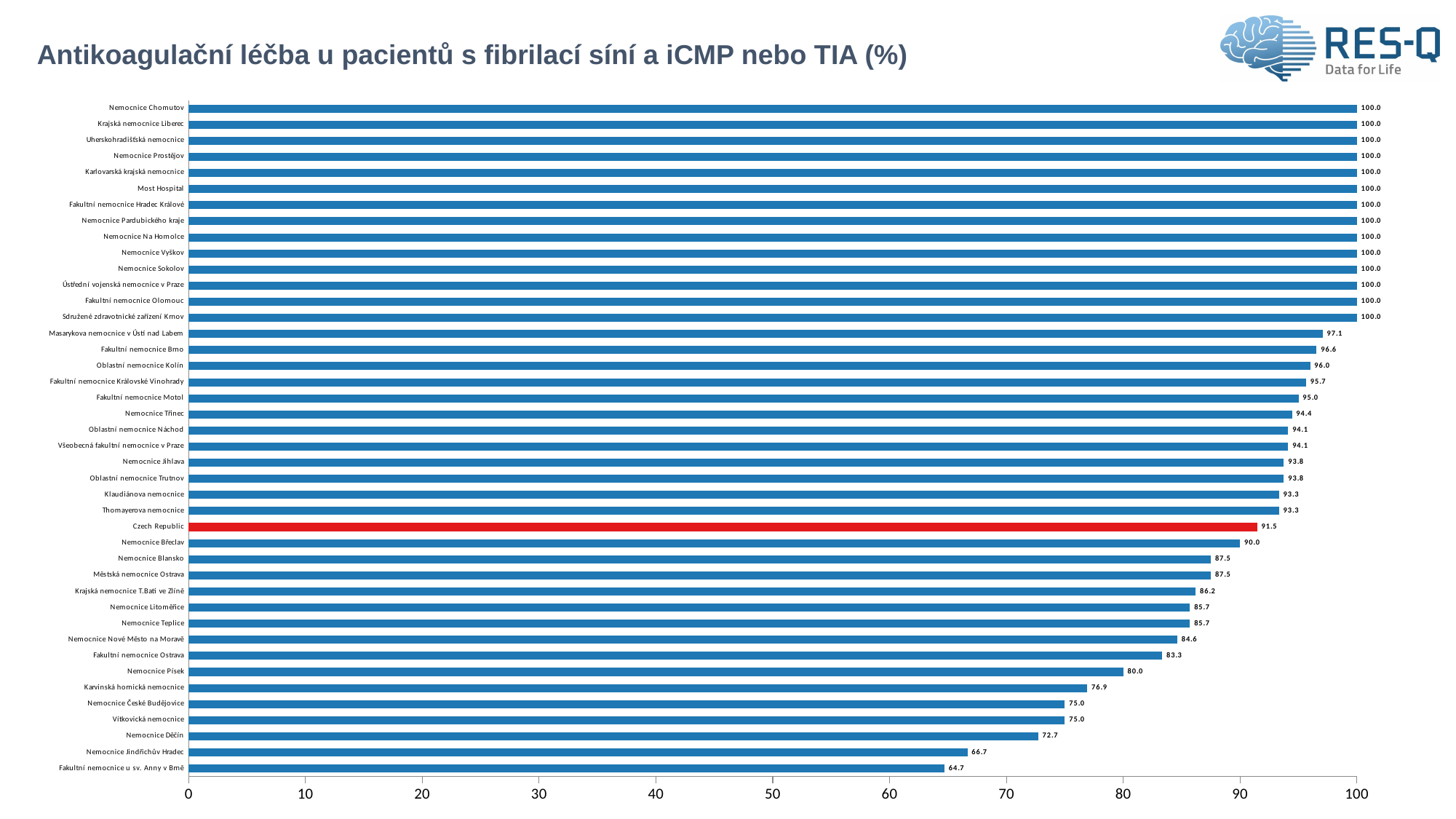
Which has a larger value, Fakultní nemocnice Brno or Fakultní nemocnice Ostrava? Fakultní nemocnice Brno What is the difference between the values for Masarykova nemocnice v Ústí nad Labem and Czech Republic? 5.6 Which hospital has the lowest value? Fakultní nemocnice u sv. Anny v Brně What is the value for Nemocnice Písek? 80.0 What is the value for Fakultní nemocnice Motol? 95.0 How many hospitals have a value of 100.0? 14 What is the value for Nemocnice Děčín? 72.7 How many bars are shown in the chart? 42 What type of chart is shown on the slide? bar chart What is the value for Czech Republic? 91.5 What is the difference between the values for Nemocnice Břeclav and Nemocnice Jindřichův Hradec? 23.3 Is the value for Karvinská hornická nemocnice greater or less than 80? less